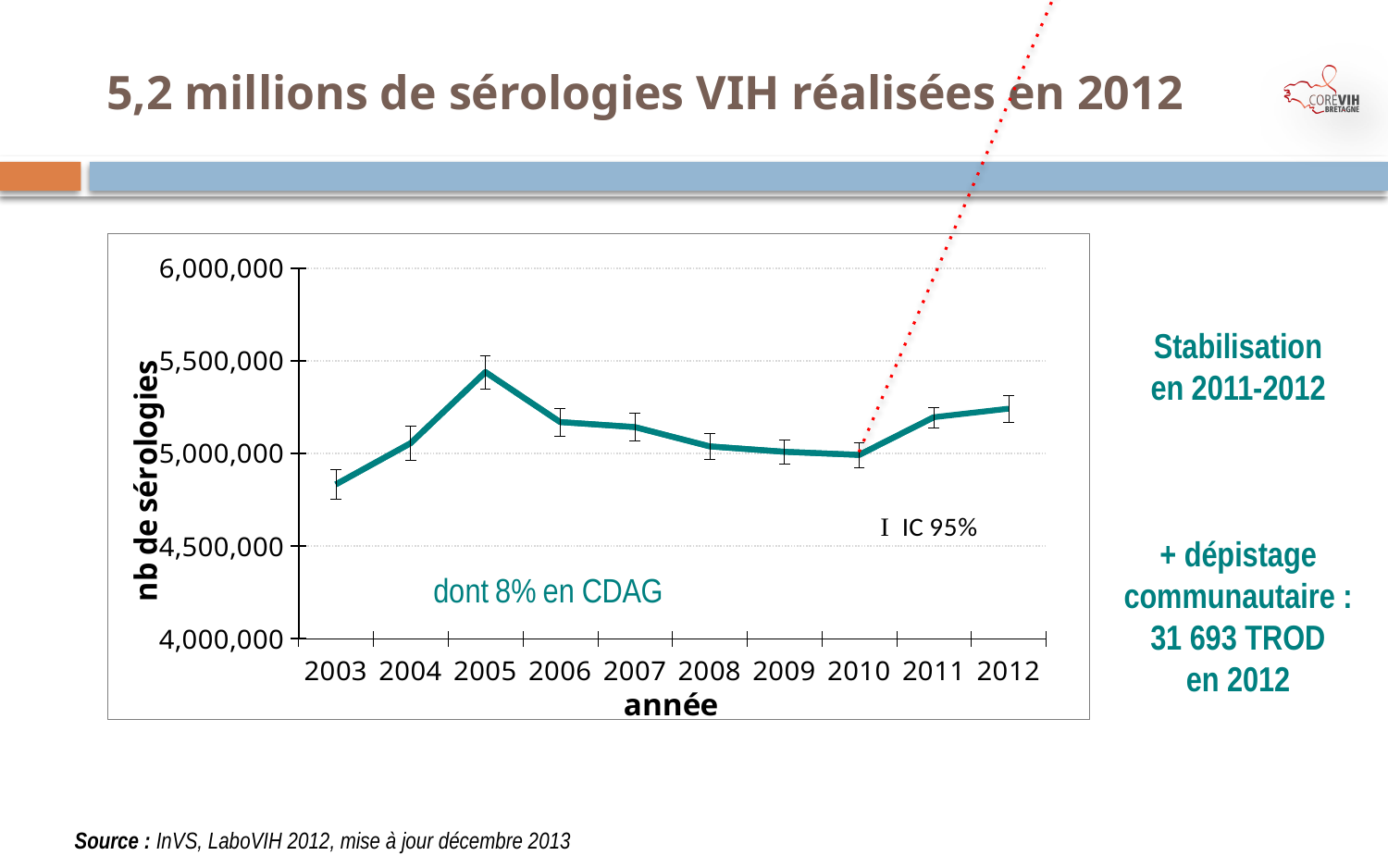
Which year has a larger value, 2012 or 2010? 2012 What is the title of the y axis of the chart? nb de sérologies Do the values rise or fall from 2005 to 2010? fall Which year has the lowest number of sérologies in the chart? 2003 What kind of chart is shown on the slide? line chart How many years are plotted along the x axis of the chart? 10 Is the value for 2005 greater or less than 5,500,000? less Which year has the highest number of sérologies in the chart? 2005 Is the value for 2003 greater or less than 5,000,000? less Is the value for 2012 greater or less than 5,000,000? greater Which year has a larger value, 2005 or 2003? 2005 What is the title of the x axis of the chart? année